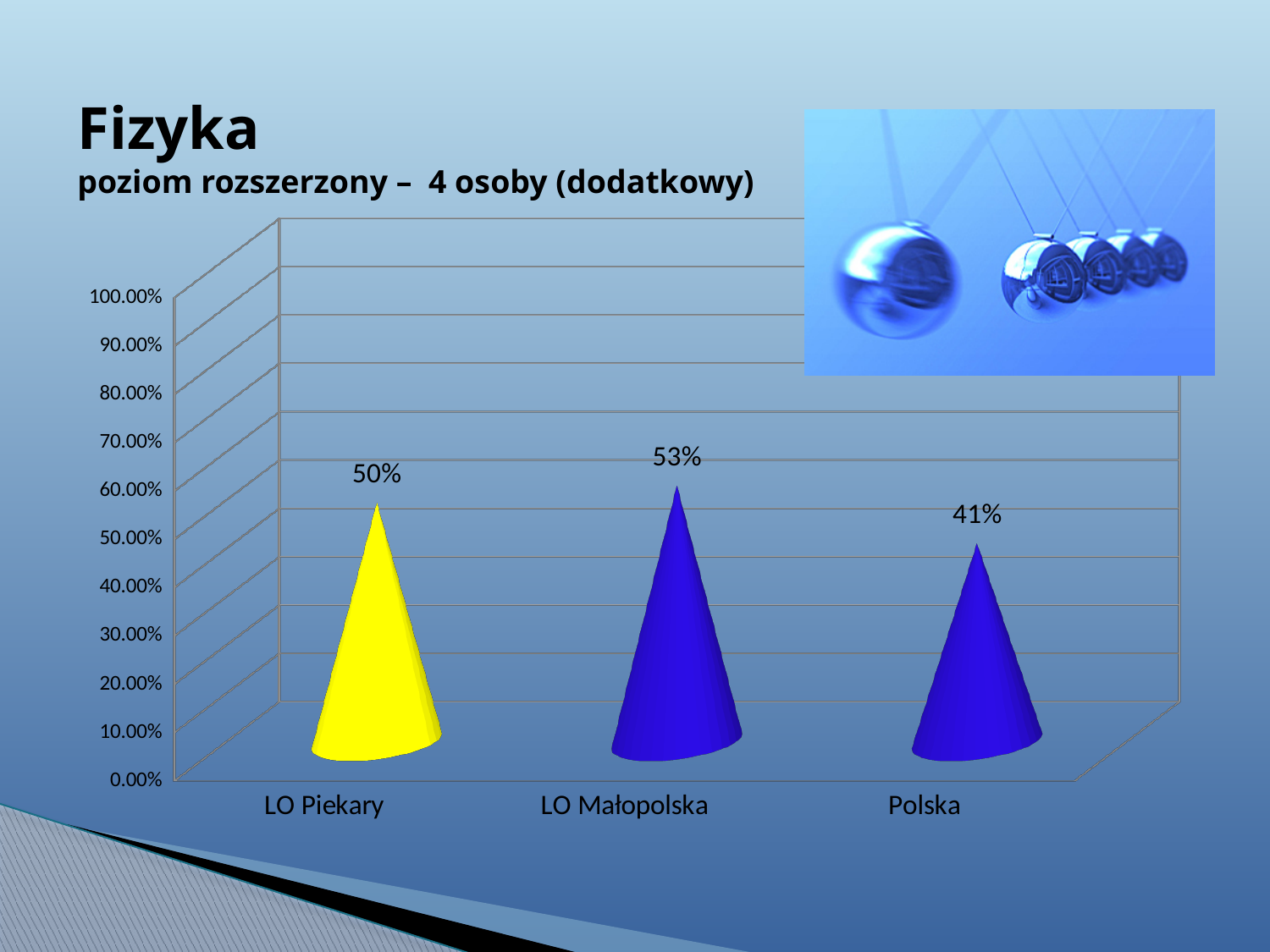
What is the difference between the values for LO Małopolska and Polska? 12% Which category has the highest value? LO Małopolska What is the value for LO Małopolska? 53% How many categories are shown on the x axis? 3 What colour is the bar for LO Piekary? yellow What kind of chart is shown on the slide? bar chart Is the value for Polska greater or less than 50.00%? less Which category has the lowest value? Polska What is the value for LO Piekary? 50% What is the difference between the values for LO Małopolska and LO Piekary? 3% What is the value for Polska? 41% Which is larger, the value for LO Piekary or the value for Polska? LO Piekary